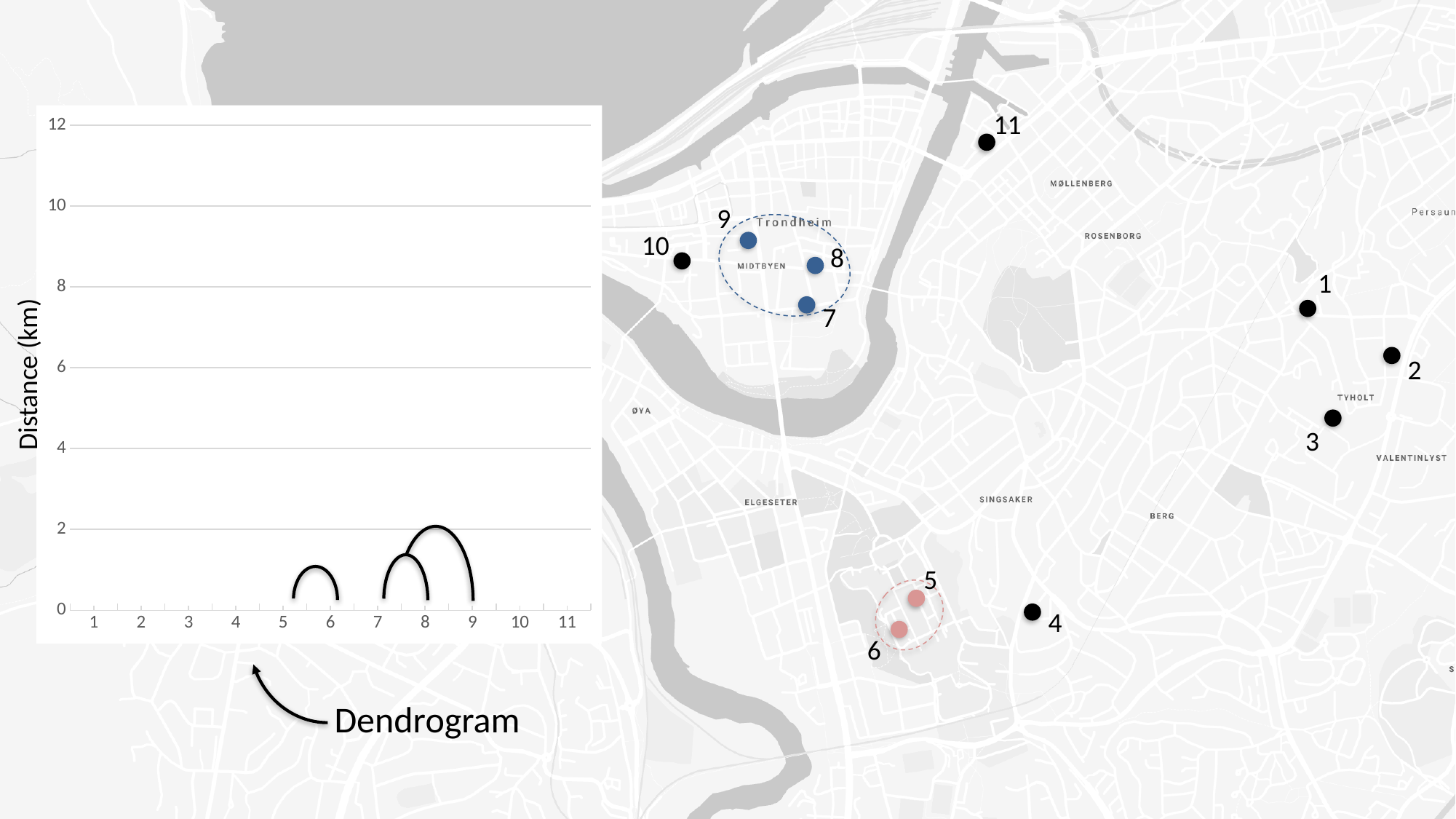
What is the highest tick value shown on the vertical axis of the dendrogram? 12 Is the merge distance joining point 9 to the 7–8 cluster greater or less than 4 km? less Is the merge distance of points 5 and 6 in the dendrogram greater or less than 2 km? less How many arcs (merges) are drawn in the dendrogram? 3 How many of the 11 points are not joined by any arc in the dendrogram? 6 How many points are labelled along the x axis of the dendrogram? 11 Which two points are joined by the leftmost arc in the dendrogram? 5 and 6 What is the label of the vertical axis of the dendrogram? Distance (km) Which merge in the dendrogram occurs at a greater distance: the 5–6 merge or the merge of 9 with the 7–8 cluster? the merge of 9 with the 7–8 cluster Which two points are joined by the lowest arc within the right-hand cluster of the dendrogram? 7 and 8 Which point joins the 7–8 cluster at the highest arc in the dendrogram? 9 What kind of chart is shown on the left of the slide? Dendrogram